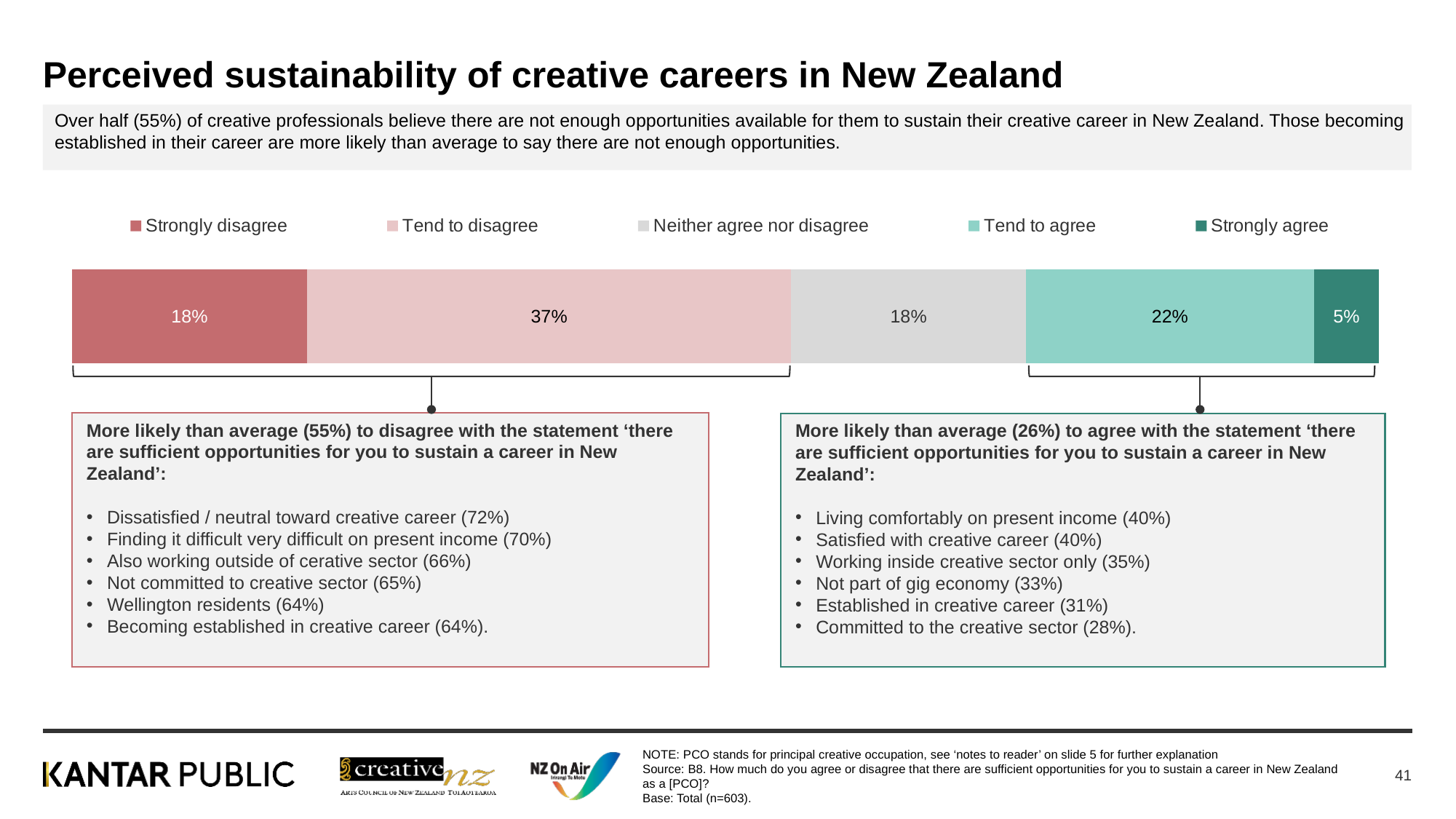
Which is larger: the 'Tend to agree' share or the 'Neither agree nor disagree' share? Tend to agree What percentage of respondents 'Tend to agree' with the statement? 22% Which response category has the smallest share in the bar? Strongly agree What colour is used for the 'Strongly agree' segment of the bar? Dark green What is the difference between the 'Tend to disagree' share and the 'Tend to agree' share? 15 percentage points What is the combined share of 'Strongly disagree' and 'Tend to disagree'? 55% What percentage of respondents 'Strongly agree' with the statement? 5% How many response categories does the legend list? 5 What kind of chart is shown on the slide? Stacked bar chart What percentage of respondents 'Tend to disagree' that there are sufficient opportunities to sustain a creative career in New Zealand? 37% Which response category has the largest share in the bar? Tend to disagree What percentage of respondents 'Strongly disagree' with the statement? 18%